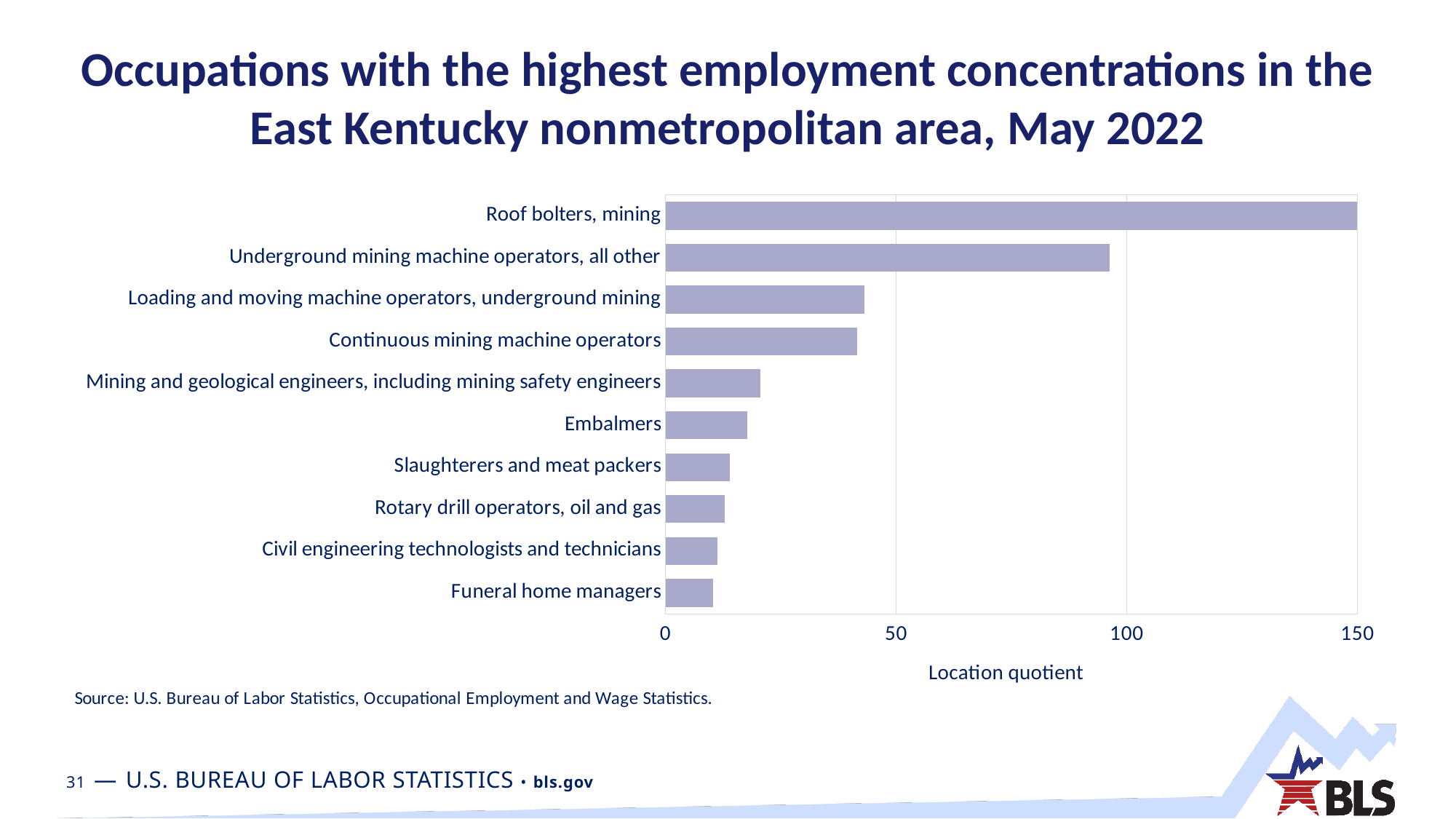
Is the location quotient for Underground mining machine operators, all other greater or less than 100? less What is the label of the horizontal axis? Location quotient How many occupations are shown in the chart? 10 What kind of chart is shown on the slide? Bar chart Which occupation has the lowest location quotient? Funeral home managers Is the location quotient for Roof bolters, mining greater or less than 100? greater Which has a larger location quotient, Roof bolters, mining or Underground mining machine operators, all other? Roof bolters, mining Is the location quotient for Mining and geological engineers, including mining safety engineers greater or less than 50? less Which occupation has the highest location quotient? Roof bolters, mining Which has a larger location quotient, Embalmers or Slaughterers and meat packers? Embalmers